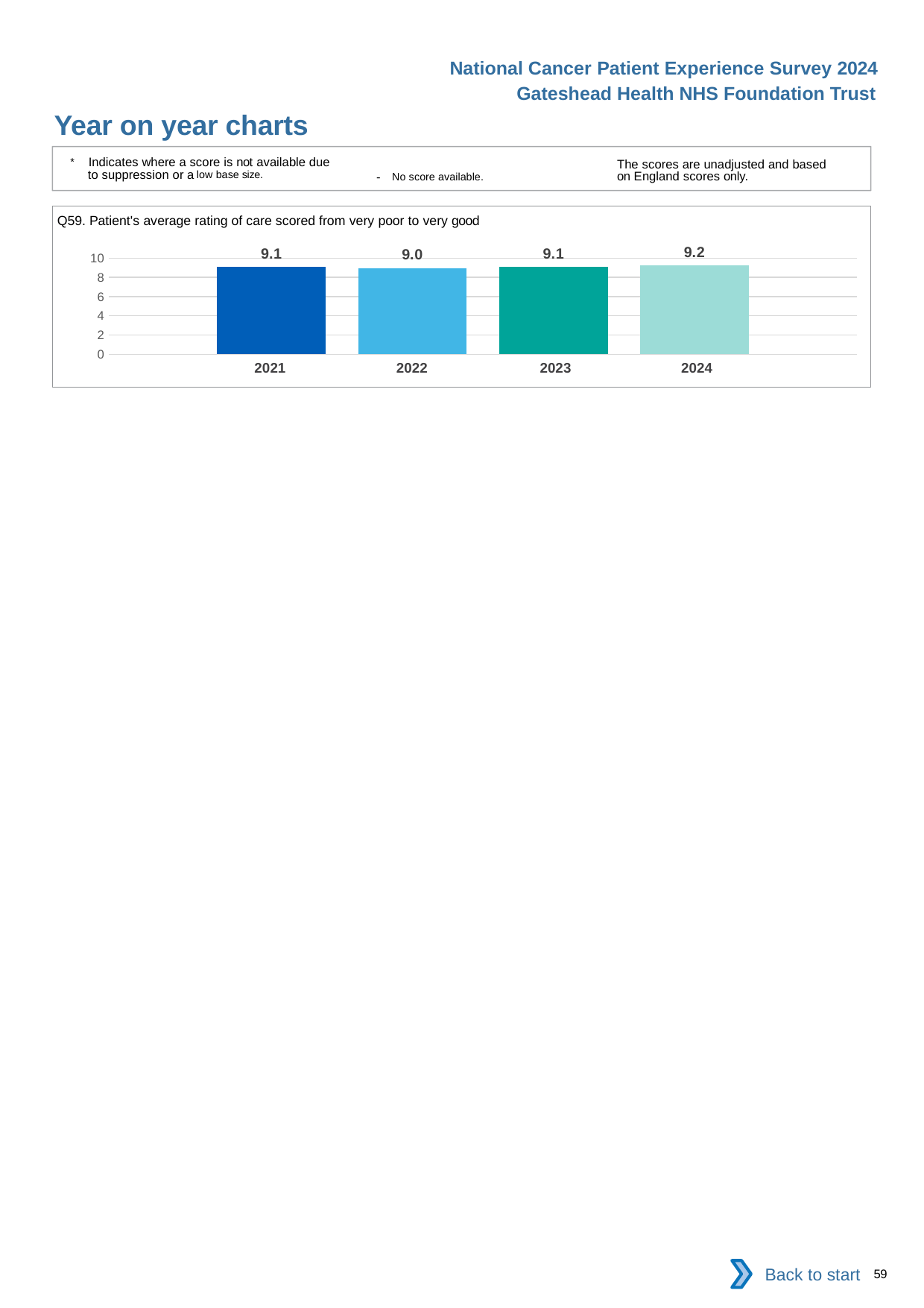
How many years are shown on the chart? 4 Is the value for 2023 greater or less than 8? greater What is the title of the chart? Q59. Patient's average rating of care scored from very poor to very good Which year has the lowest value? 2022 What is the value for 2021? 9.1 Which is larger, the value for 2024 or the value for 2022? 2024 What kind of chart is shown? bar chart What is the value for 2024? 9.2 What is the value for 2022? 9.0 What is the difference between the values for 2024 and 2022? 0.2 What is the value for 2023? 9.1 Which year has the highest value? 2024